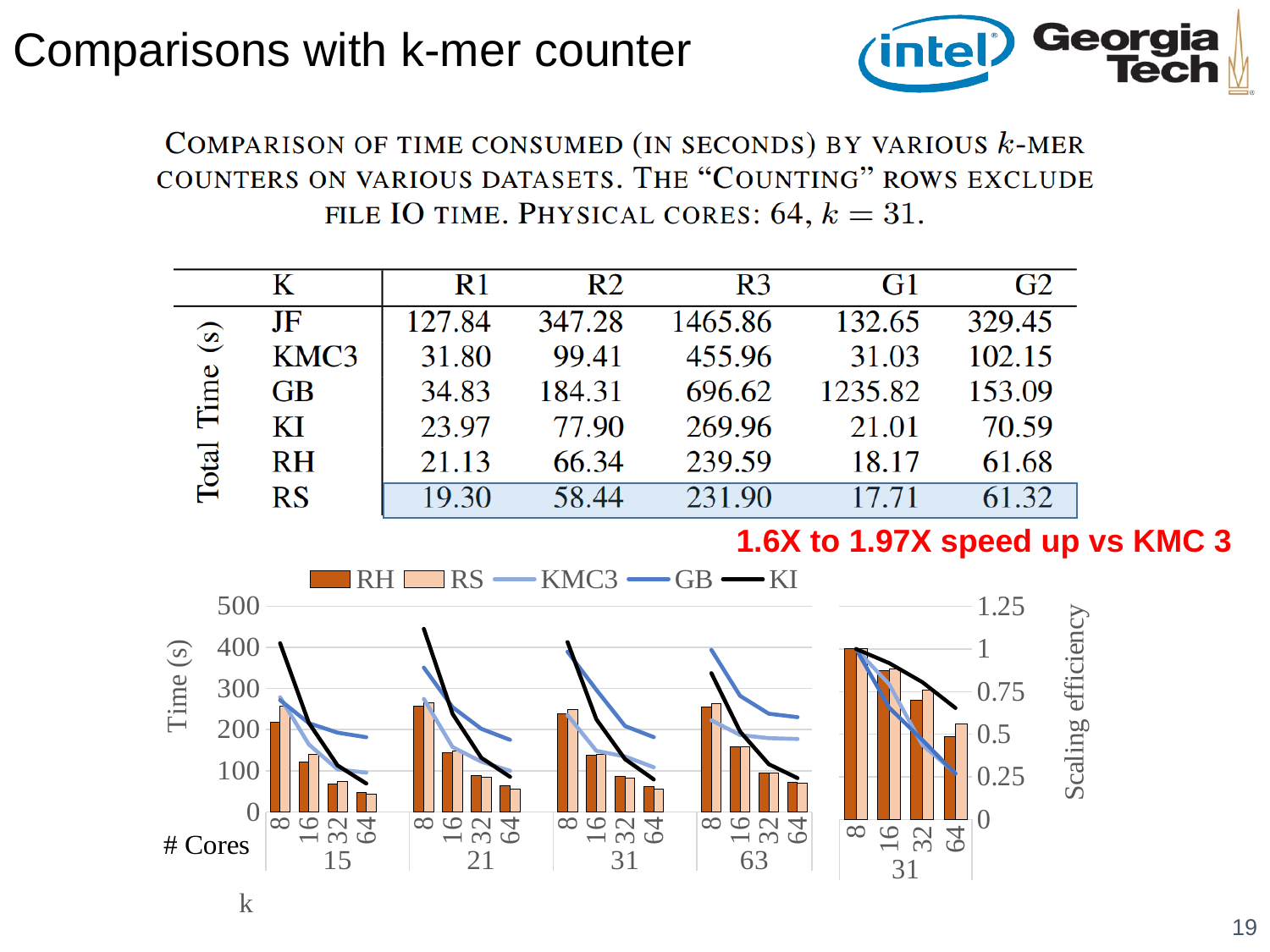
What is the label of the right-hand vertical axis of the chart? Scaling efficiency In the chart, which series has the highest time at 8 cores for k = 21? KI How many series does the legend of the chart list? 5 In the chart, is the value for GB at 8 cores with k = 63 greater or less than 300? greater In the chart, how many core counts are plotted for each value of k? 4 In the chart, is the value for KI at 8 cores with k = 21 greater or less than 400? greater In the chart, for k = 15 at 16 cores, which is larger, RH or RS? RS In the chart, is the value for RH at 64 cores with k = 15 greater or less than 100? less In the chart, how does the time for RH change as the number of cores increases from 8 to 64 for k = 31? It falls What kind of chart is shown at the bottom of the slide? Bar chart with line series In the chart, how many values of k are shown in the Time (s) panel? 4